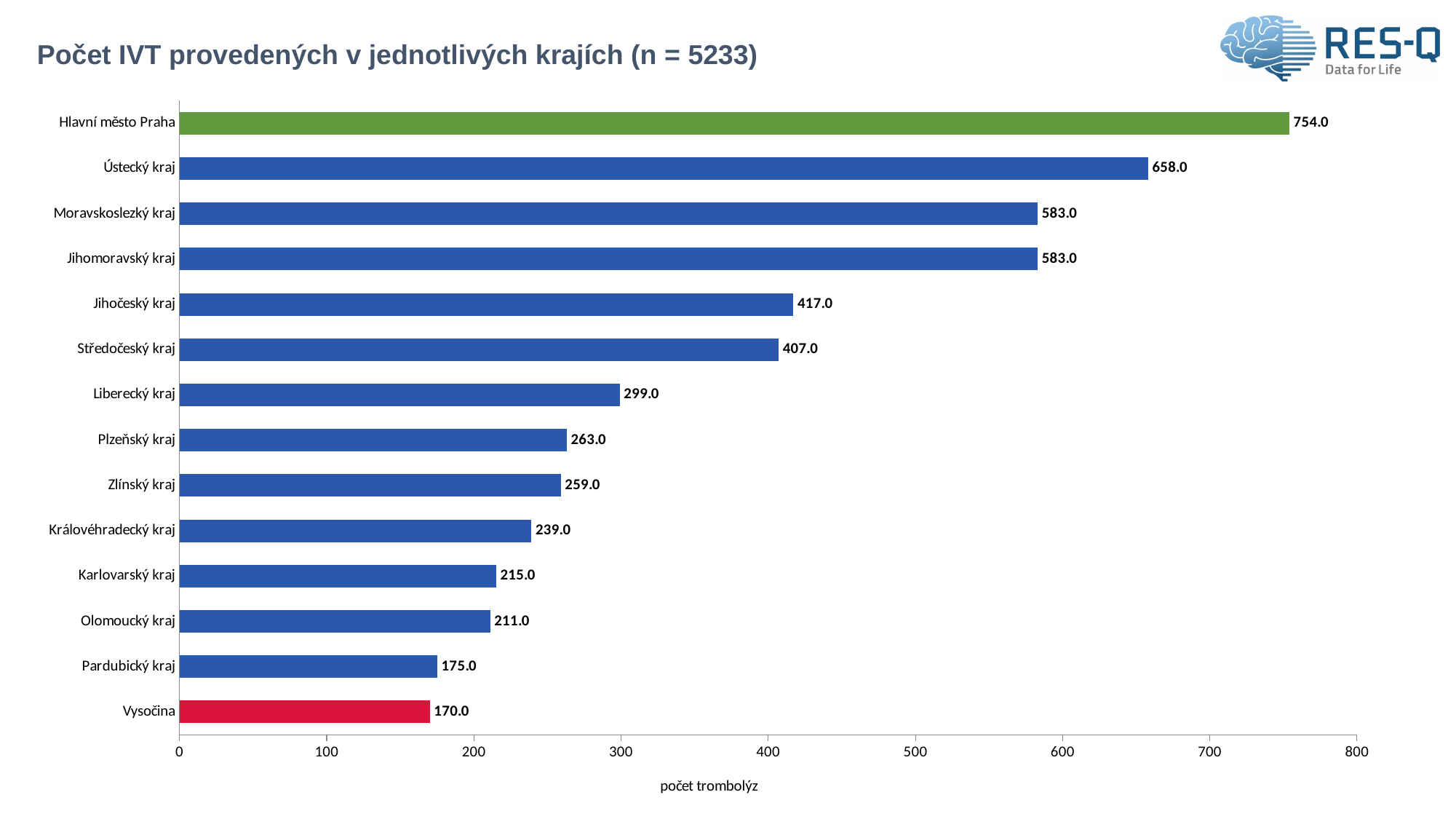
What kind of chart is shown on the slide? bar chart Which region has the highest value? Hlavní město Praha Which region has the lowest value? Vysočina Is the value for Moravskoslezský kraj greater or less than 500? greater Which has a larger value, Středočeský kraj or Plzeňský kraj? Středočeský kraj How many regions are shown in the chart? 14 What is the value for Karlovarský kraj? 215.0 What is the difference between the values for Pardubický kraj and Vysočina? 5.0 What is the difference between the values for Ústecký kraj and Jihočeský kraj? 241.0 What is the value for Hlavní město Praha? 754.0 What is the value for Liberecký kraj? 299.0 What is the title of the chart? Počet IVT provedených v jednotlivých krajích (n = 5233)